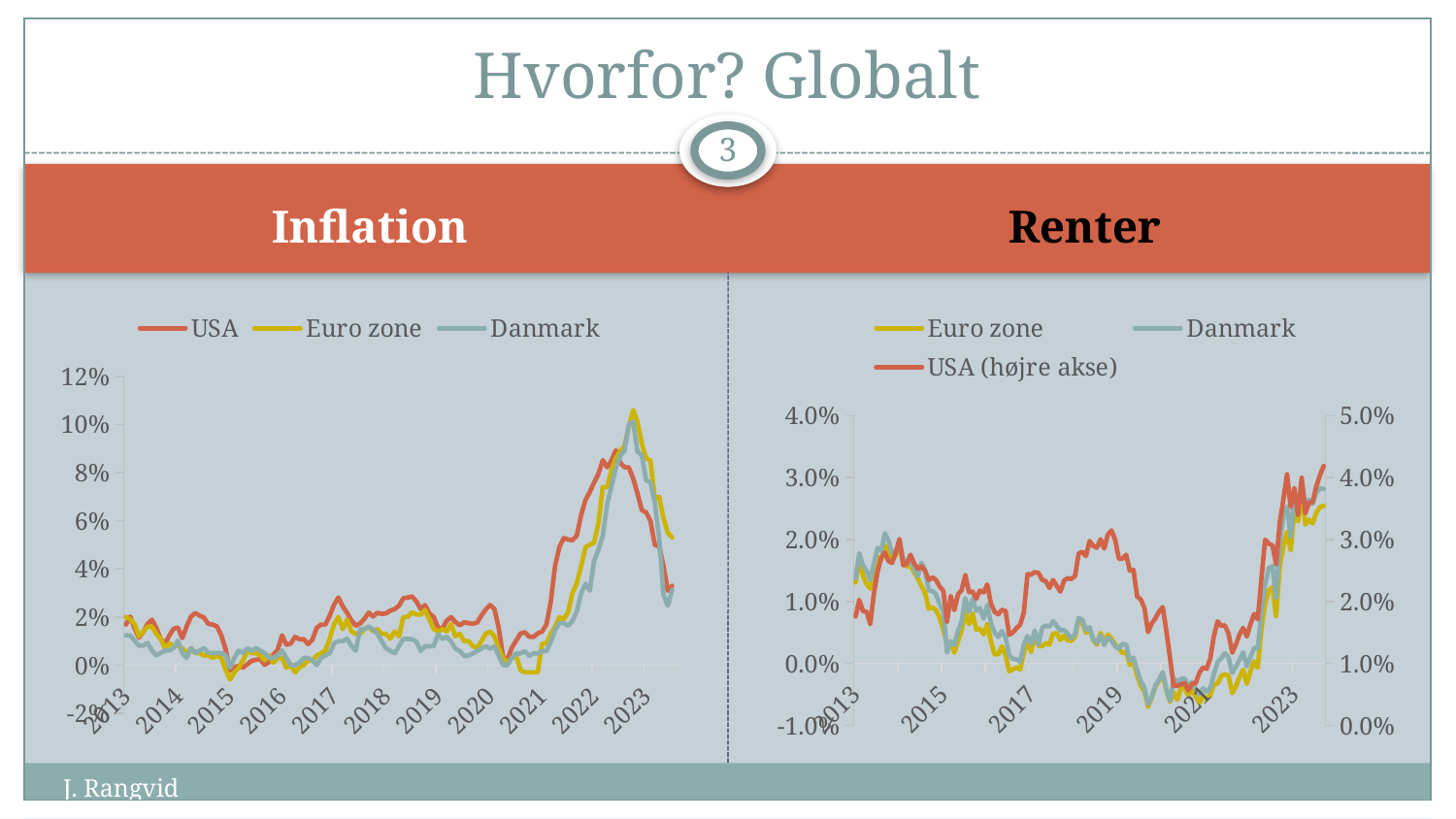
In the Inflation chart, is the Euro zone value at the start of 2021 greater or less than 2%? less In the Renter chart, which series is plotted on the right-hand axis? USA How many series does the legend of the Renter chart list? 3 In the Inflation chart, which series reaches the highest peak? Euro zone In the Inflation chart, do the values rise or fall between 2021 and 2022? rise In the Renter chart, is the Euro zone value in 2020 greater or less than 0.0%? less In the Inflation chart, is the peak value for USA greater or less than 8%? greater What is the title of the chart on the right side of the slide? Renter What kind of chart is the Inflation chart on the left? line chart How many series does the legend of the Inflation chart list? 3